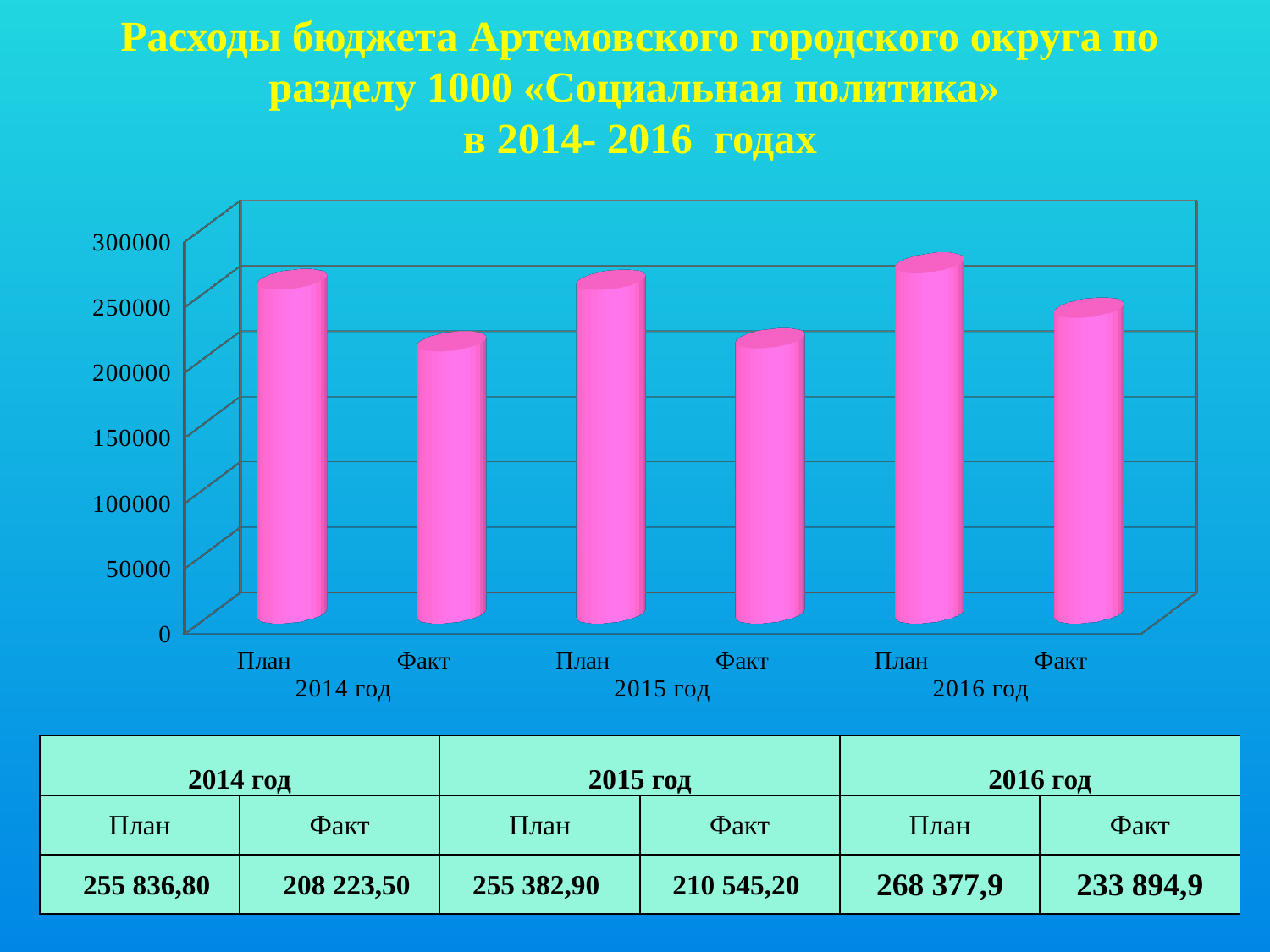
What type of chart is shown on the slide? bar chart Which bar has the highest value? План 2016 год What is the value for Факт in 2016 год? 233 894,9 What is the value for План in 2016 год? 268 377,9 How many bars are shown in the chart? 6 Which is larger, Факт in 2016 год or Факт in 2015 год? Факт in 2016 год What is the value for План (plan) in 2014 год? 255 836,80 Is the value for Факт in 2014 год greater or less than 250000? less Which bar has the lowest value? Факт 2014 год What is the value for Факт (actual) in 2015 год? 210 545,20 What is the difference between План and Факт in 2014 год? 47 613,30 What is the difference between План and Факт in 2015 год? 44 837,70